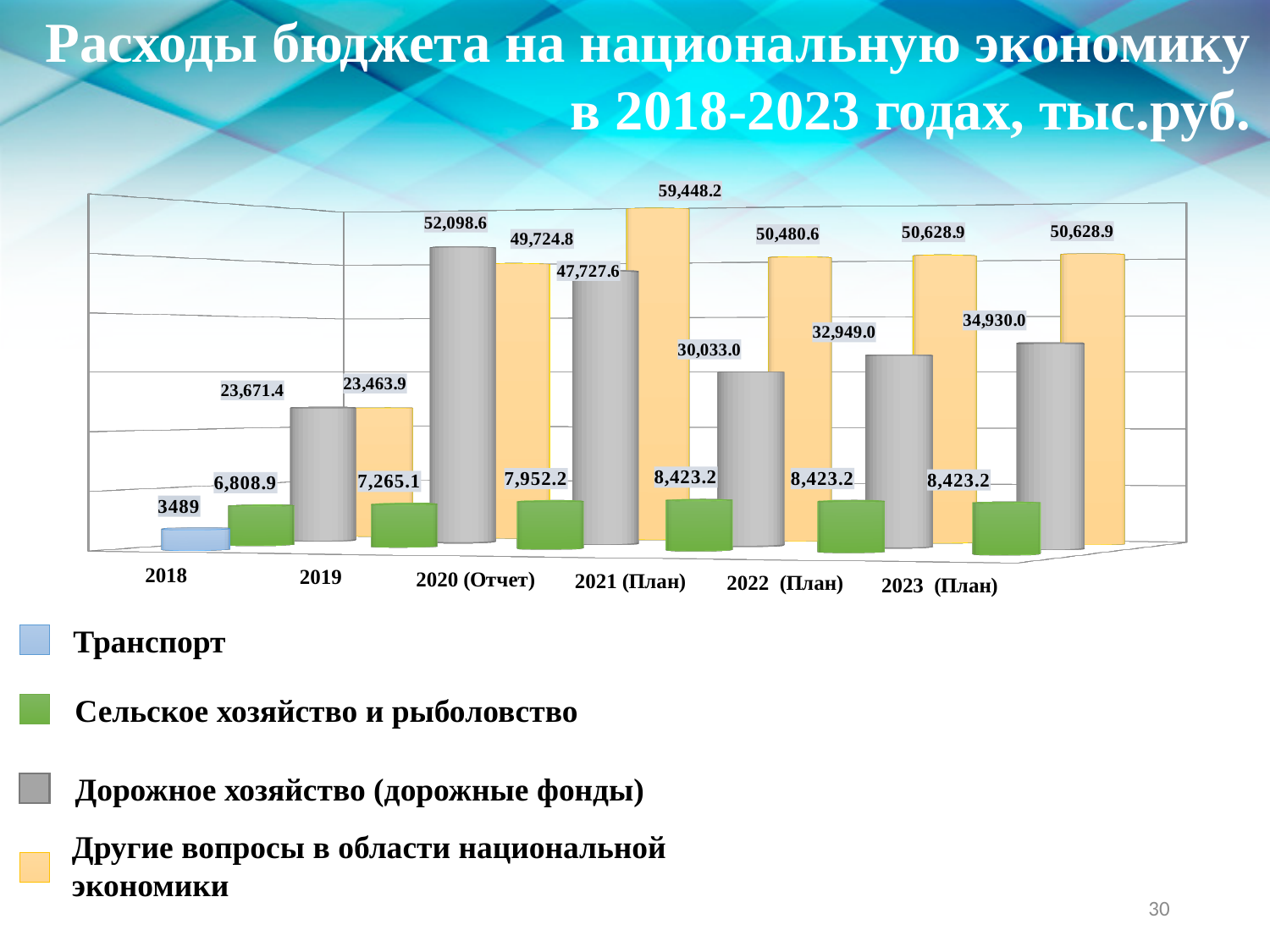
What is the value for Другие вопросы в области национальной экономики in 2020 (Отчет)? 59,448.2 What is the value for Сельское хозяйство и рыболовство in 2021 (План)? 8,423.2 What unit is stated in the chart title? тыс.руб. What is the value for Транспорт in 2018? 3489 Does the value for Сельское хозяйство и рыболовство rise or fall from 2018 to 2021 (План)? rise Which is larger in 2018: Дорожное хозяйство (дорожные фонды) or Другие вопросы в области национальной экономики? Дорожное хозяйство (дорожные фонды) What is the difference between the Дорожное хозяйство (дорожные фонды) values for 2023 (План) and 2022 (План)? 1,981.0 How many year categories are shown on the x axis? 6 How many series does the legend list? 4 What is the value for Дорожное хозяйство (дорожные фонды) in 2019? 52,098.6 What type of chart is shown on the slide? bar chart In which year is the value for Дорожное хозяйство (дорожные фонды) highest? 2019